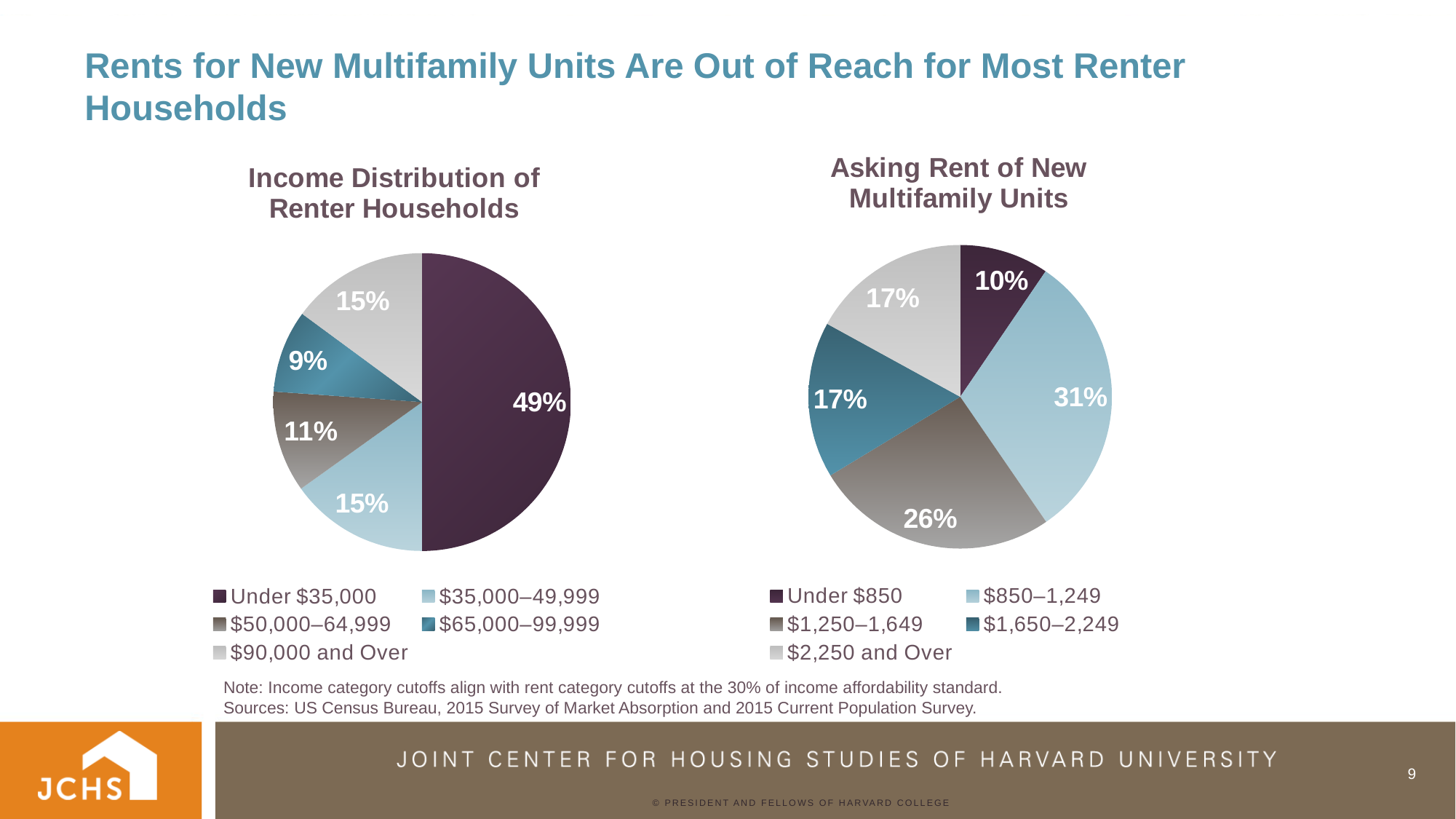
In the 'Asking Rent of New Multifamily Units' chart, what share of units have asking rents of $850–1,249? 31% In the 'Asking Rent of New Multifamily Units' chart, what is the difference between the share for $850–1,249 and the share for $1,250–1,649? 5 percentage points In the 'Asking Rent of New Multifamily Units' chart, which rent category has the largest share? $850–1,249 How many categories does the legend of the 'Income Distribution of Renter Households' chart list? 5 In the 'Income Distribution of Renter Households' chart, which income category has the largest share? Under $35,000 In the 'Asking Rent of New Multifamily Units' chart, which rent category has the smallest share? Under $850 In the 'Income Distribution of Renter Households' chart, what is the combined share of the $35,000–49,999 and $90,000 and Over categories? 30% In the 'Asking Rent of New Multifamily Units' chart, what share of units have asking rents under $850? 10% In the 'Income Distribution of Renter Households' chart, which income category has the smallest share? $65,000–99,999 In the 'Income Distribution of Renter Households' chart, what share of renter households have incomes under $35,000? 49% In the 'Income Distribution of Renter Households' chart, which is larger: the share for $50,000–64,999 or the share for $65,000–99,999? $50,000–64,999 What kind of chart is the 'Asking Rent of New Multifamily Units' chart? Pie chart